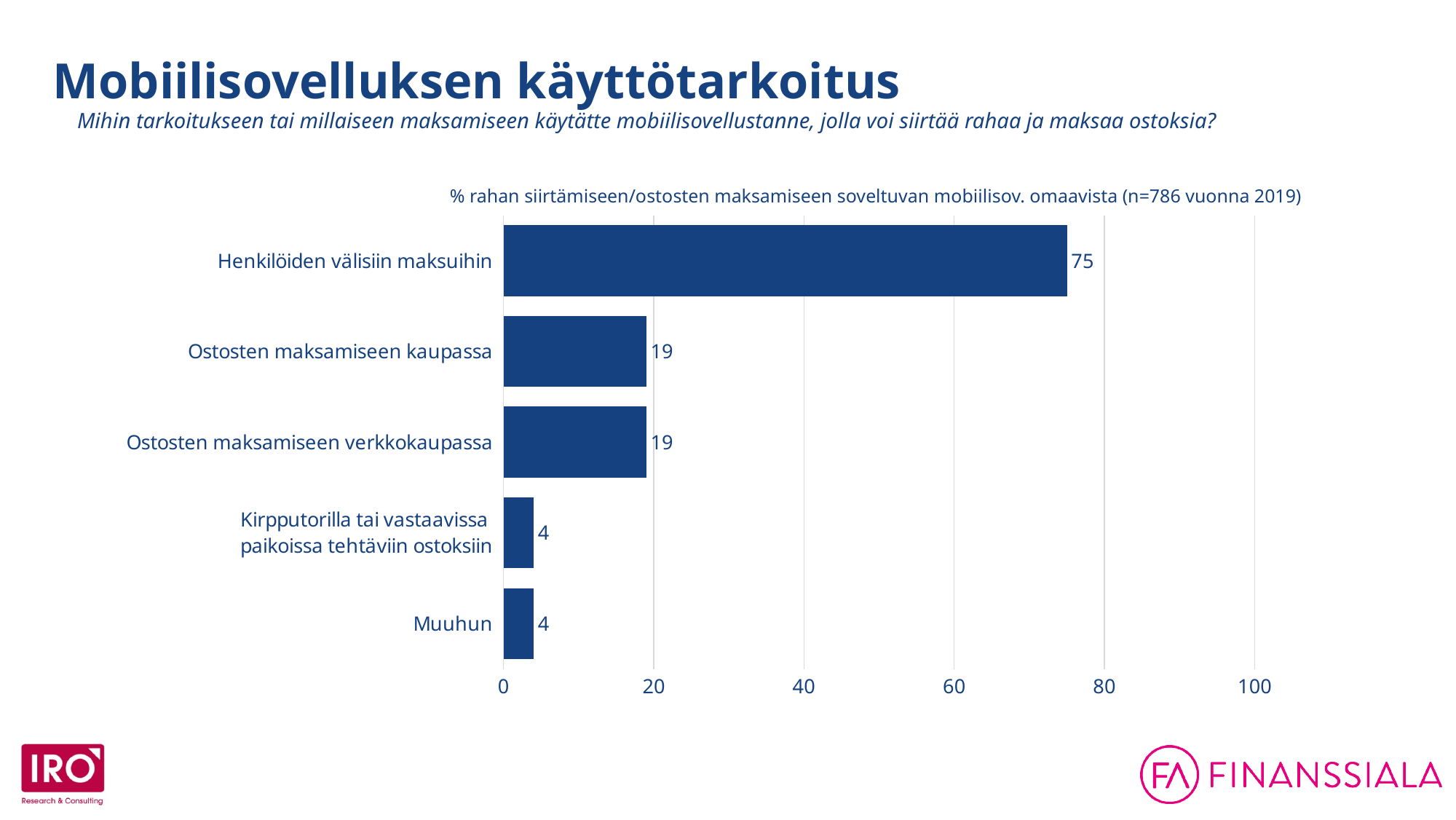
Which category has the highest value? Henkilöiden välisiin maksuihin What is the difference between the values for Henkilöiden välisiin maksuihin and Ostosten maksamiseen kaupassa? 56 What is the value for Muuhun? 4 Is the value for Henkilöiden välisiin maksuihin greater or less than 60? greater What is the difference between the values for Ostosten maksamiseen kaupassa and Muuhun? 15 What is the value for Kirpputorilla tai vastaavissa paikoissa tehtäviin ostoksiin? 4 What is the title of the slide? Mobiilisovelluksen käyttötarkoitus What is the value for Ostosten maksamiseen verkkokaupassa? 19 What is the value for Henkilöiden välisiin maksuihin? 75 Which is larger, the value for Ostosten maksamiseen kaupassa or the value for Muuhun? Ostosten maksamiseen kaupassa What kind of chart is shown on the slide? bar chart How many categories are shown in the chart? 5